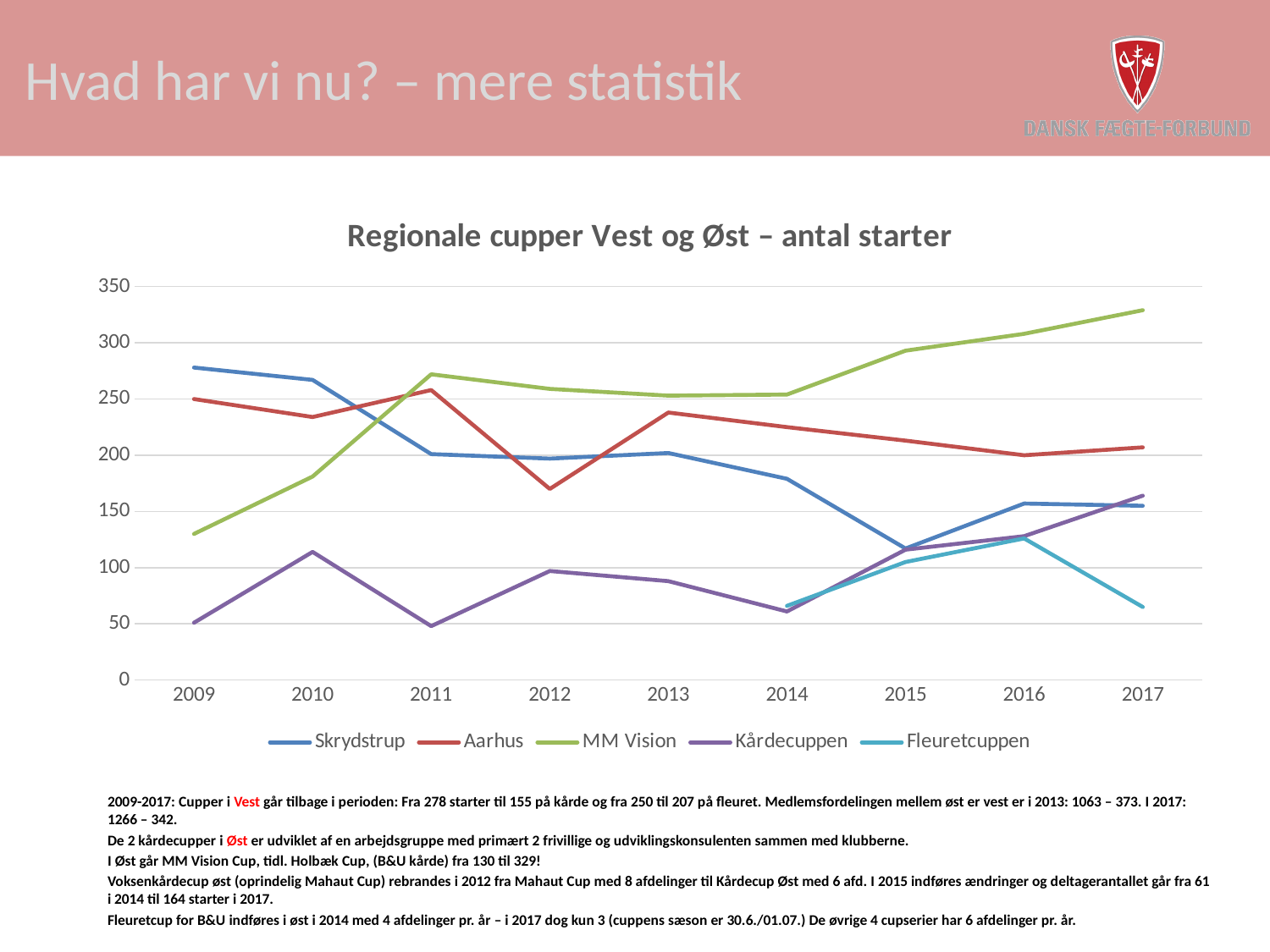
Is the value for Kårdecuppen in 2011 greater or less than 100? less How many series does the legend list? 5 What is the title of the chart? Regionale cupper Vest og Øst – antal starter What type of chart is shown on the slide? line chart Which series has the lowest value in 2017? Fleuretcuppen How many years are shown on the x axis? 9 In 2009, which series has the larger value, Skrydstrup or MM Vision? Skrydstrup Does the MM Vision line rise or fall from 2014 to 2017? rises Is the value for Aarhus in 2012 greater or less than 200? less Which series has the highest value in 2017? MM Vision In 2013, which series has the larger value, Aarhus or Skrydstrup? Aarhus Is the value for MM Vision in 2017 greater or less than 300? greater